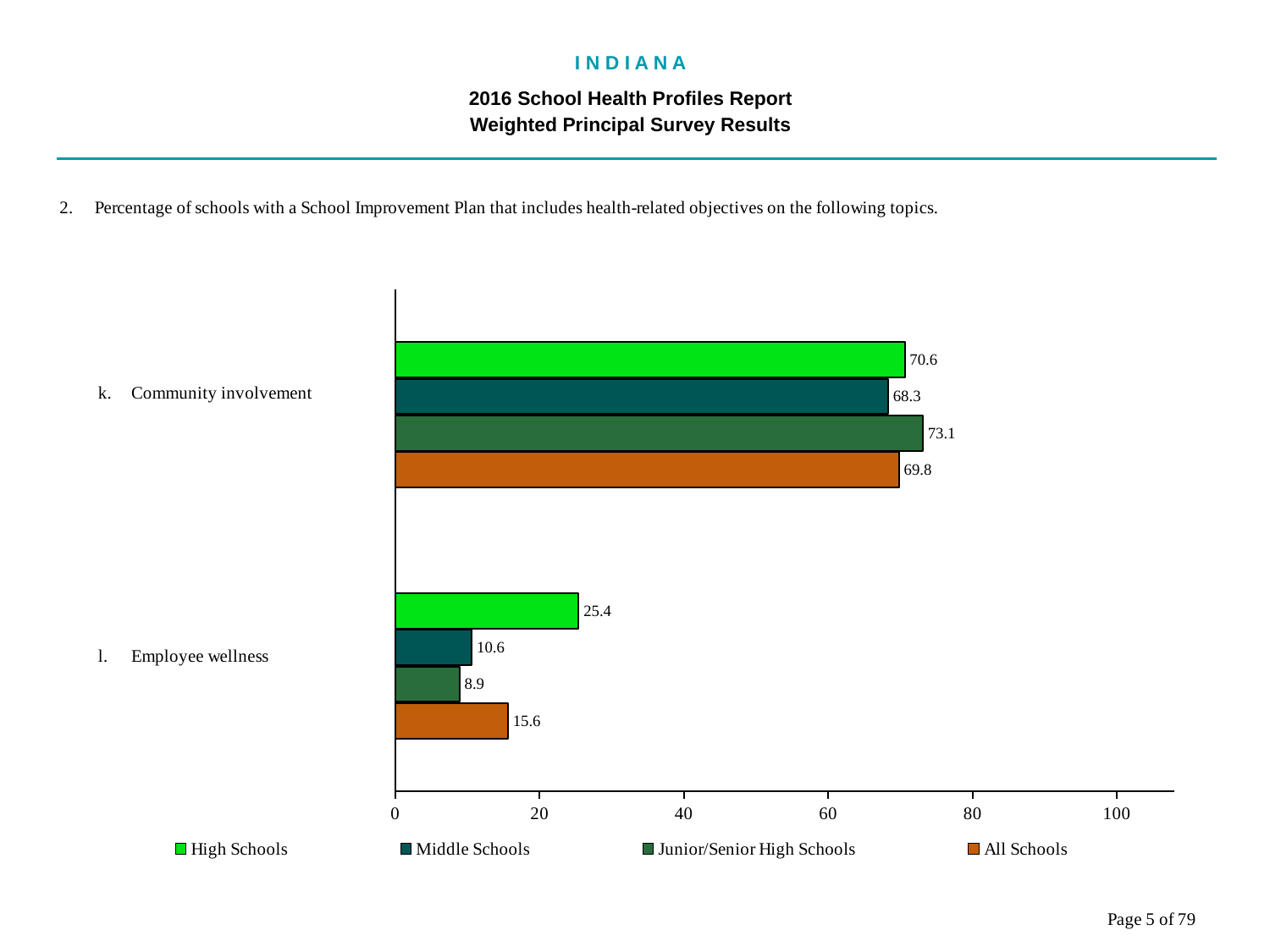
What is the value for All Schools for Community involvement? 69.8 What kind of chart is shown on the slide? bar chart How many topics are shown on the chart? 2 Which school type has the lowest value for Employee wellness? Junior/Senior High Schools Is the value for All Schools for Employee wellness greater or less than 20? less What is the value for High Schools for Community involvement? 70.6 Which series is shown in orange in the legend? All Schools Which school type has the highest value for Community involvement? Junior/Senior High Schools Which is larger for Community involvement: the Middle Schools value or the All Schools value? All Schools How many series does the legend list? 4 What is the value for Middle Schools for Employee wellness? 10.6 What is the difference between the High Schools and Middle Schools values for Employee wellness? 14.8